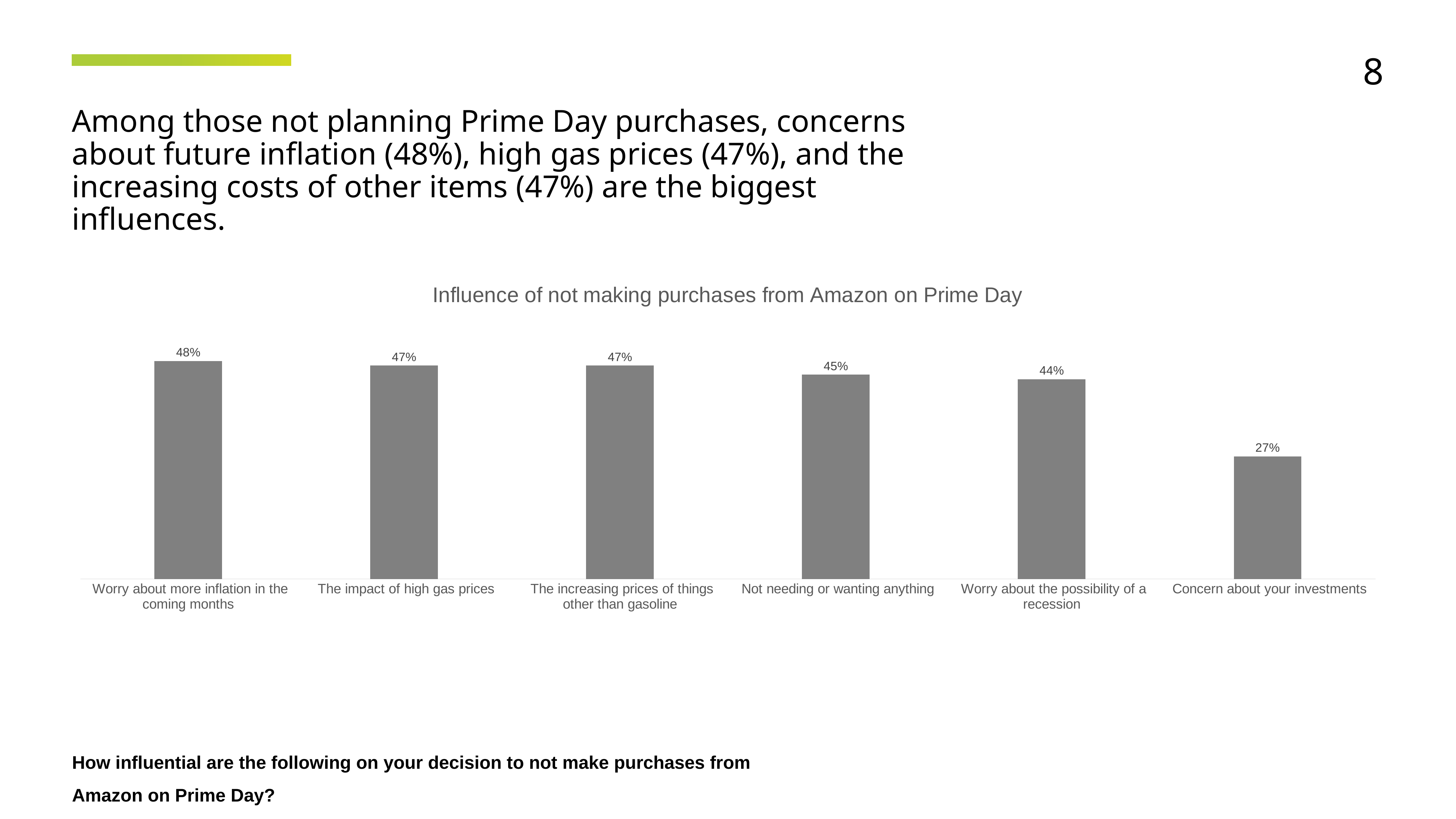
Which is larger: the value for "Worry about the possibility of a recession" or the value for "Concern about your investments"? Worry about the possibility of a recession Which category has the highest value? Worry about more inflation in the coming months What is the value for "Concern about your investments"? 27% What is the difference between the values for "Not needing or wanting anything" and "Worry about the possibility of a recession"? 1% What is the value for "Worry about more inflation in the coming months"? 48% How many categories are shown in the chart? 6 What is the value for "Not needing or wanting anything"? 45% What is the value for "Worry about the possibility of a recession"? 44% What is the difference between the values for "Worry about more inflation in the coming months" and "Concern about your investments"? 21% What is the title of the chart? Influence of not making purchases from Amazon on Prime Day Which category has the lowest value? Concern about your investments What is the value for "The impact of high gas prices"? 47%